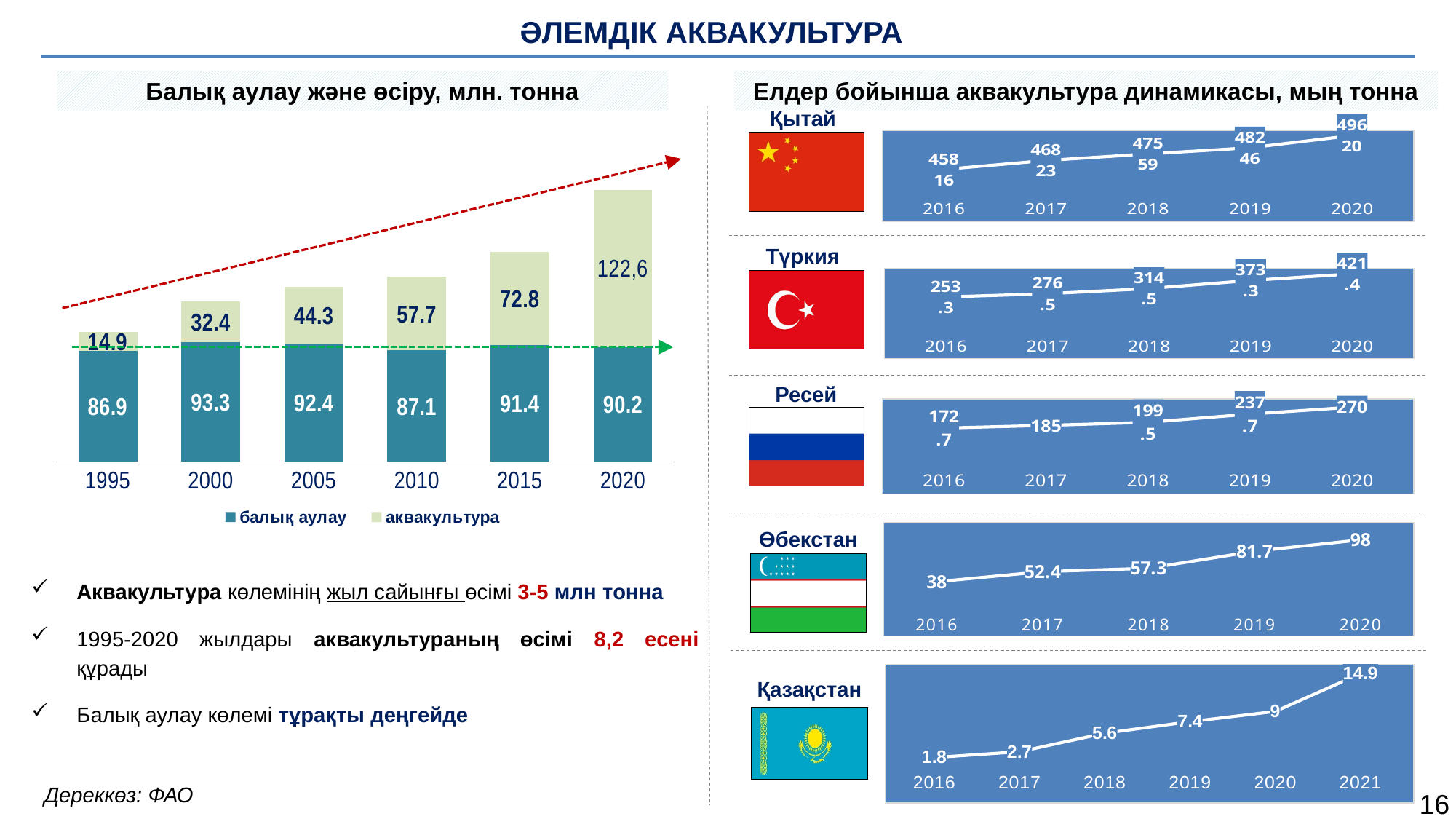
In the left chart 'Балық аулау және өсіру, млн. тонна', does the аквакультура value rise or fall from 1995 to 2020? rise In the left chart 'Балық аулау және өсіру, млн. тонна', what is the value of балық аулау for 2000? 93.3 In the left chart 'Балық аулау және өсіру, млн. тонна', how many series does the legend list? 2 In the Түркия chart on the right, which is larger, the value for 2018 or the value for 2019? 2019 In the Ресей chart on the right, which year has the lowest value? 2016 In the left chart 'Балық аулау және өсіру, млн. тонна', what is the total of the stacked bar for 2015? 164.2 In the Өзбекстан chart on the right, what is the difference between the 2020 and 2016 values? 60 In the left chart 'Балық аулау және өсіру, млн. тонна', which year has the highest балық аулау value? 2000 In the Қазақстан chart on the right, what is the value for 2021? 14.9 In the left chart 'Балық аулау және өсіру, млн. тонна', what is the value of аквакультура for 2020? 122,6 What kind of chart is the left chart 'Балық аулау және өсіру, млн. тонна'? stacked bar chart In the Қазақстан chart on the right, how many years are plotted? 6